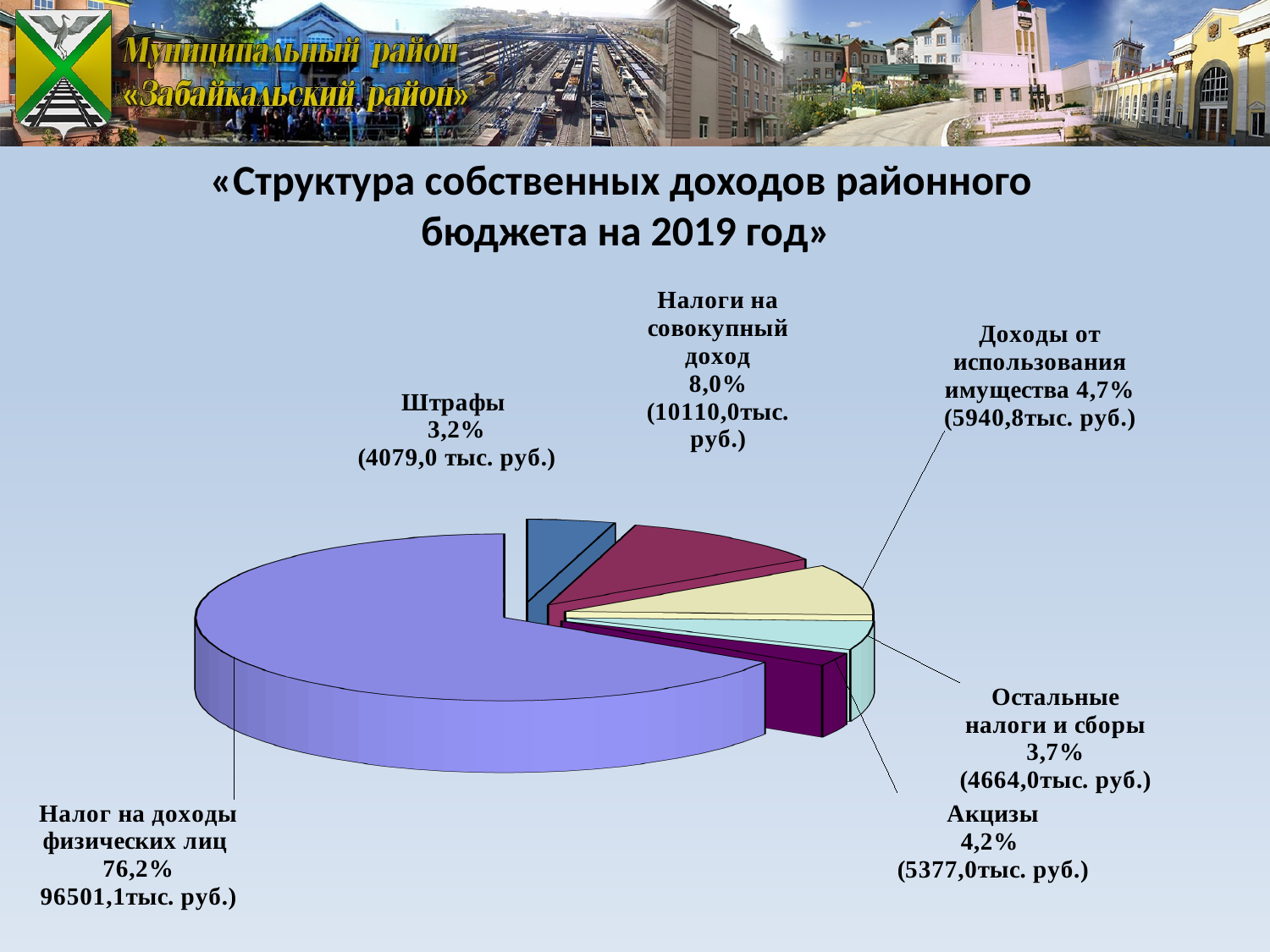
Which category has the largest share of the pie? Налог на доходы физических лиц What percentage is shown for «Остальные налоги и сборы»? 3,7% What percentage is shown for «Штрафы»? 3,2% How many categories (slices) does the pie chart have? 6 Which category has the smallest share of the pie? Штрафы What is the difference in percentage points between «Налоги на совокупный доход» and «Штрафы»? 4,8% What type of chart is shown on the slide? Pie chart Which is larger: the share of «Доходы от использования имущества» or the share of «Акцизы»? Доходы от использования имущества What is the title of the chart on the slide? «Структура собственных доходов районного бюджета на 2019 год» What is the value in thousand rubles for «Налоги на совокупный доход»? 10110,0 тыс. руб. What is the value in thousand rubles for «Акцизы»? 5377,0 тыс. руб. What share of the pie does «Налог на доходы физических лиц» represent? 76,2%